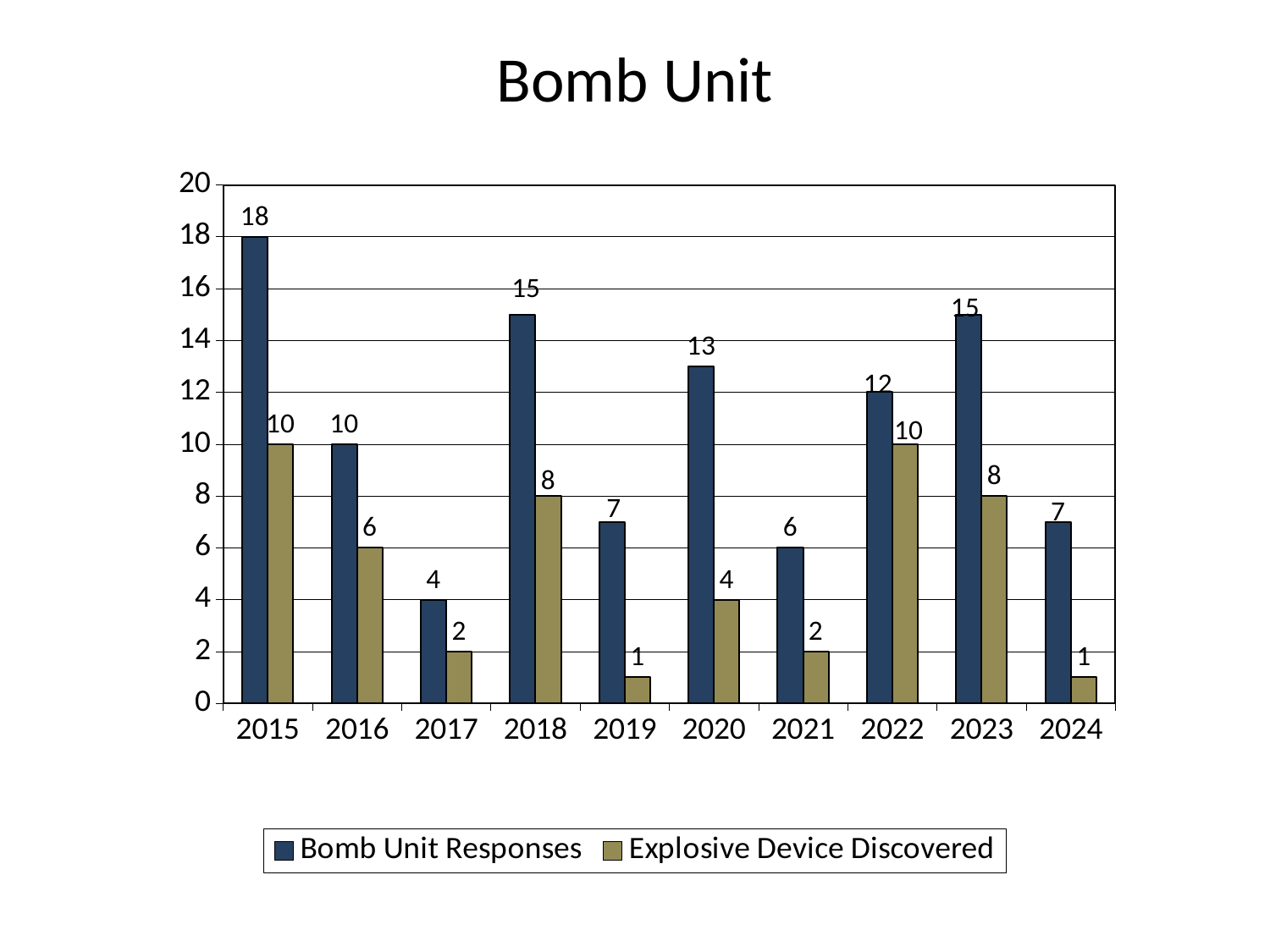
What is the difference between Bomb Unit Responses and Explosive Device Discovered in 2018? 7 What is the value for Bomb Unit Responses in 2015? 18 Which year has the highest value for Bomb Unit Responses? 2015 What is the value for Explosive Device Discovered in 2020? 4 What kind of chart is shown on the slide? Bar chart What is the value for Bomb Unit Responses in 2022? 12 Which year has the lowest value for Bomb Unit Responses? 2017 What is the difference between Bomb Unit Responses in 2015 and in 2024? 11 How many years are shown on the x axis? 10 What is the title of the chart? Bomb Unit Which is larger: Explosive Device Discovered in 2016 or in 2023? 2023 How many series does the legend list? 2